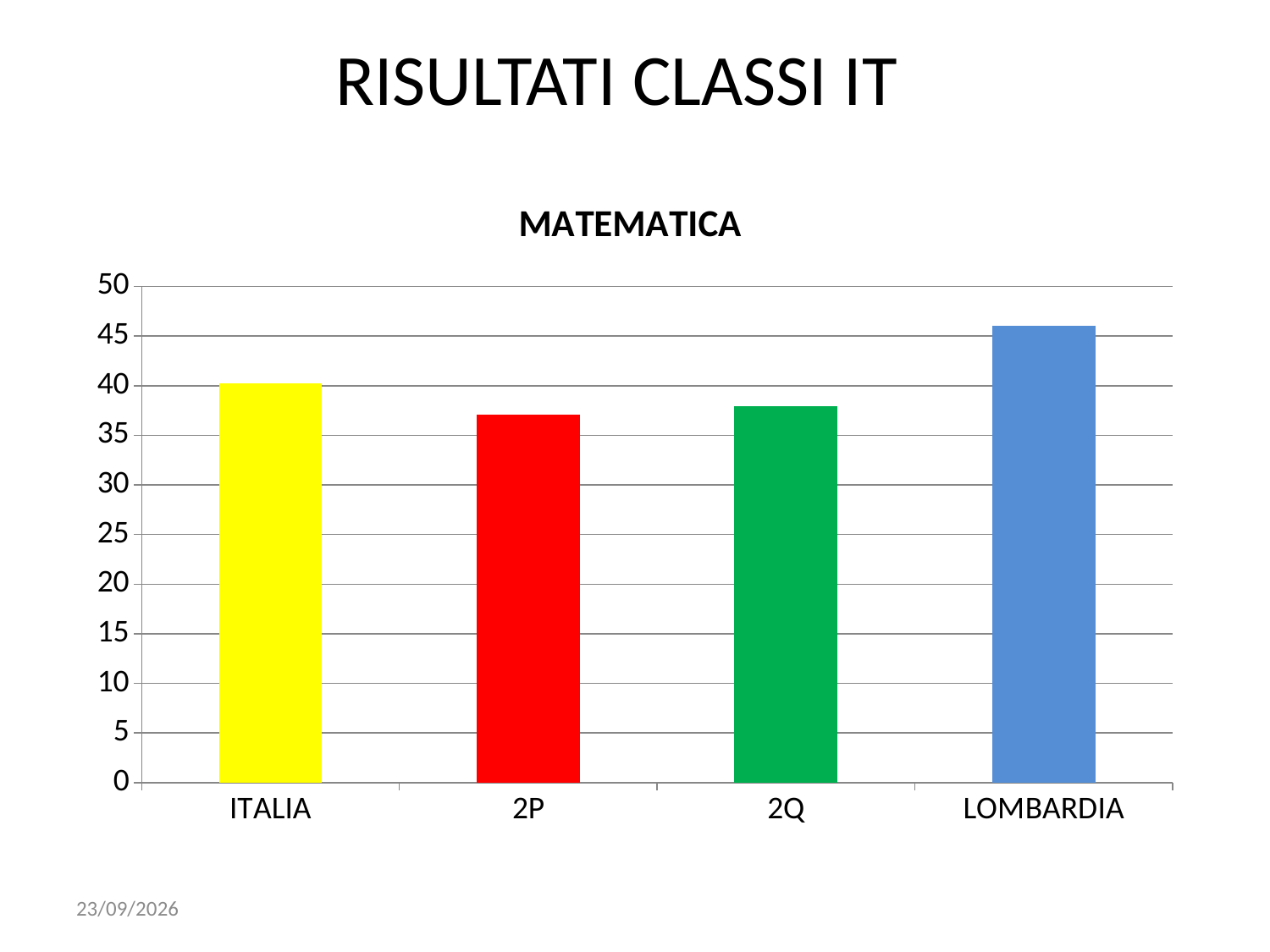
Which is larger, the value for LOMBARDIA or the value for 2Q? LOMBARDIA Is the value for 2P greater or less than 35? greater Is the value for LOMBARDIA greater or less than 45? greater What colour is the bar for LOMBARDIA? blue Is the value for 2P greater or less than 40? less Which category has the highest value in the chart? LOMBARDIA What kind of chart is shown on the slide? bar chart Which is larger, the value for ITALIA or the value for 2P? ITALIA How many categories are shown on the x axis of the chart? 4 What is the title of the chart? MATEMATICA